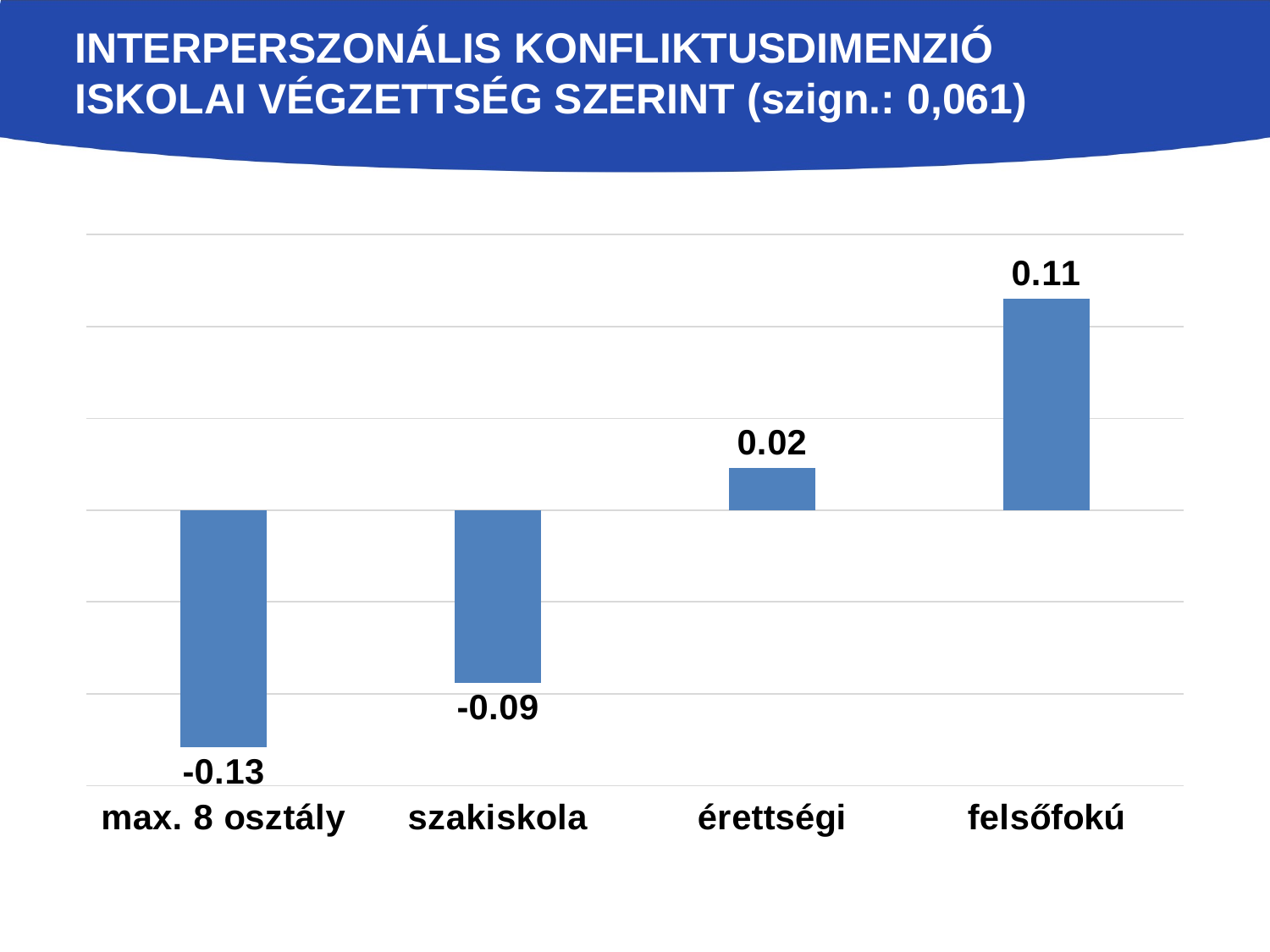
What is the difference between the values for szakiskola and max. 8 osztály? 0.04 What is the value for érettségi? 0.02 What is the difference between the values for felsőfokú and érettségi? 0.09 What is the value for szakiskola? -0.09 What kind of chart is shown on the slide? bar chart Which is larger, the value for szakiskola or the value for érettségi? érettségi Which category has the lowest value? max. 8 osztály How many categories are shown in the chart? 4 What is the value for felsőfokú? 0.11 Which category has the highest value? felsőfokú What is the value for max. 8 osztály? -0.13 Do the values rise or fall from left to right across the categories? rise